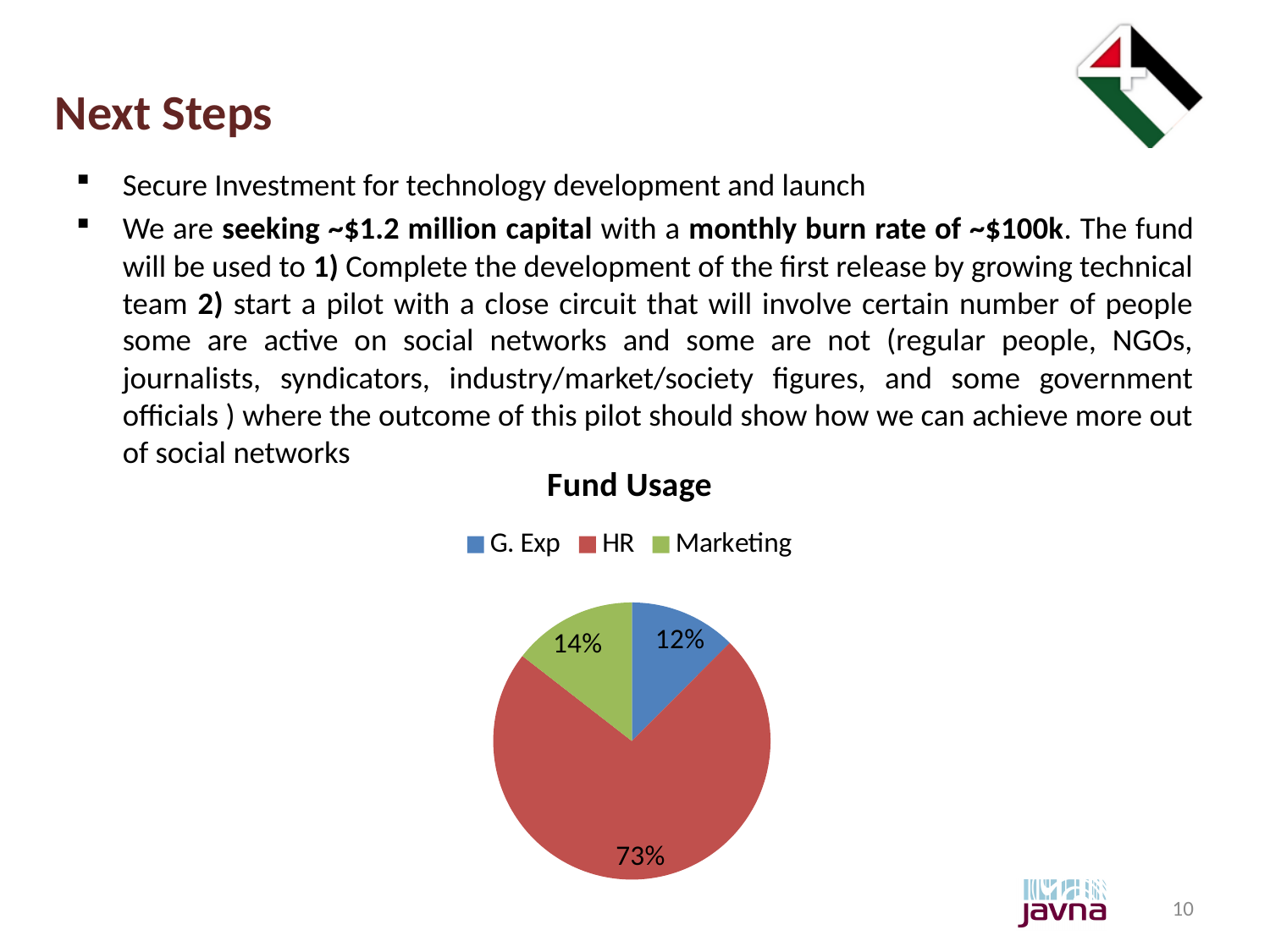
What is the difference in percentage points between the HR slice and the Marketing slice? 59 What colour is the HR slice in the Fund Usage pie chart? red How many categories does the Fund Usage pie chart show? 3 Which slice is larger in the Fund Usage pie chart, Marketing or G. Exp? Marketing What share of the fund usage pie is allocated to Marketing? 14% What share of the fund usage pie is allocated to HR? 73% What type of chart is shown under the title "Fund Usage"? pie chart Which category has the largest slice in the Fund Usage pie chart? HR What share of the fund usage pie is allocated to G. Exp? 12% What is the title of the chart on the slide? Fund Usage Which category has the smallest slice in the Fund Usage pie chart? G. Exp How many entries does the legend of the Fund Usage chart list? 3